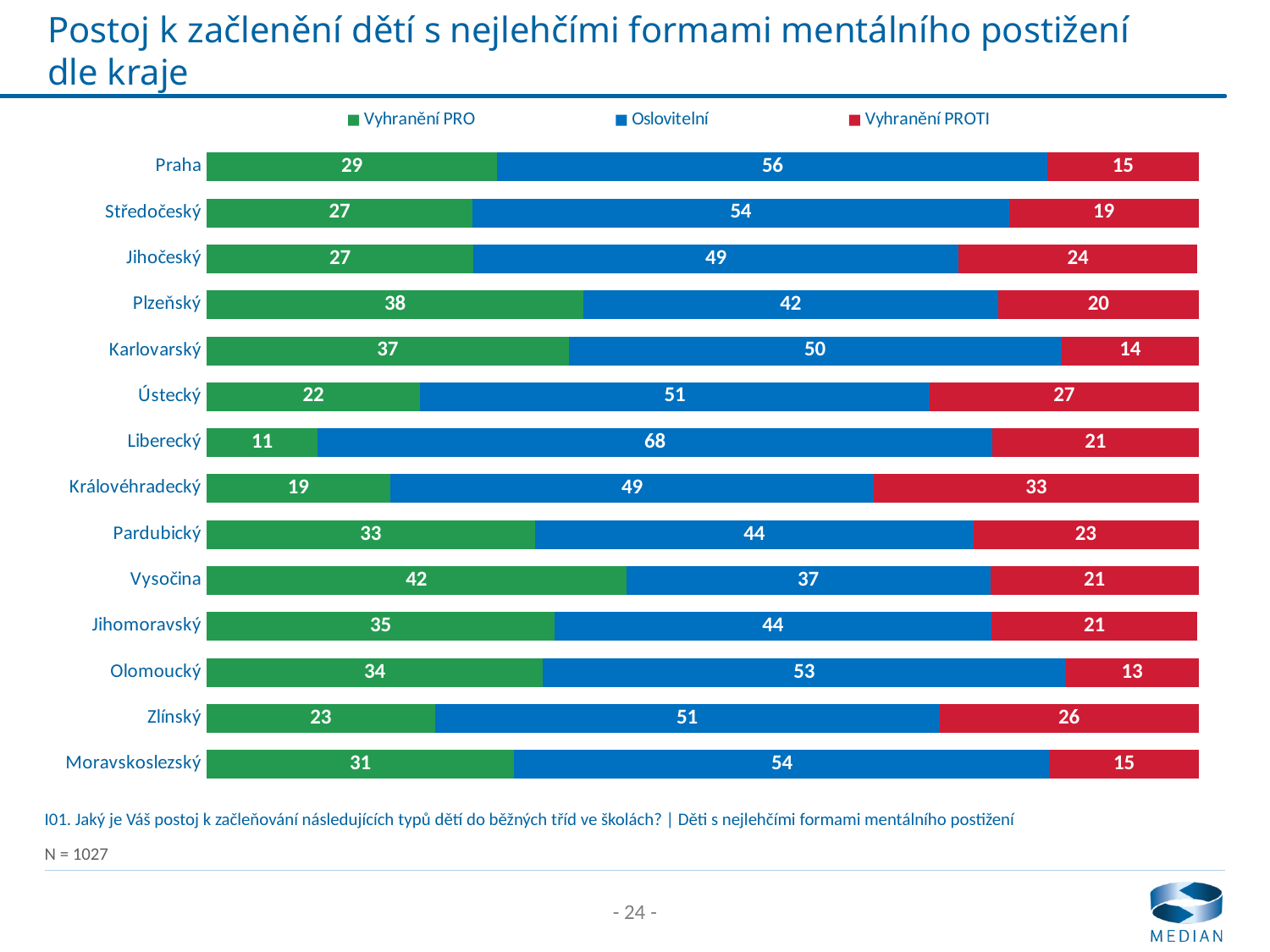
How many regions are shown in the chart? 14 How many series does the legend list? 3 Which region has the lowest Vyhranění PROTI value? Olomoucký What is the total of the stacked bar for Praha? 100 What is the Oslovitelní value for Liberecký? 68 What is the difference between the Oslovitelní and Vyhranění PRO values for Liberecký? 57 Which is larger: the Vyhranění PROTI value for Ústecký or for Zlínský? Ústecký Which region has the highest Vyhranění PRO value? Vysočina What is the Vyhranění PROTI value for Královéhradecký? 33 What kind of chart is shown on the slide? Stacked bar chart Which region has the lowest Vyhranění PRO value? Liberecký What is the Vyhranění PRO value for Plzeňský? 38